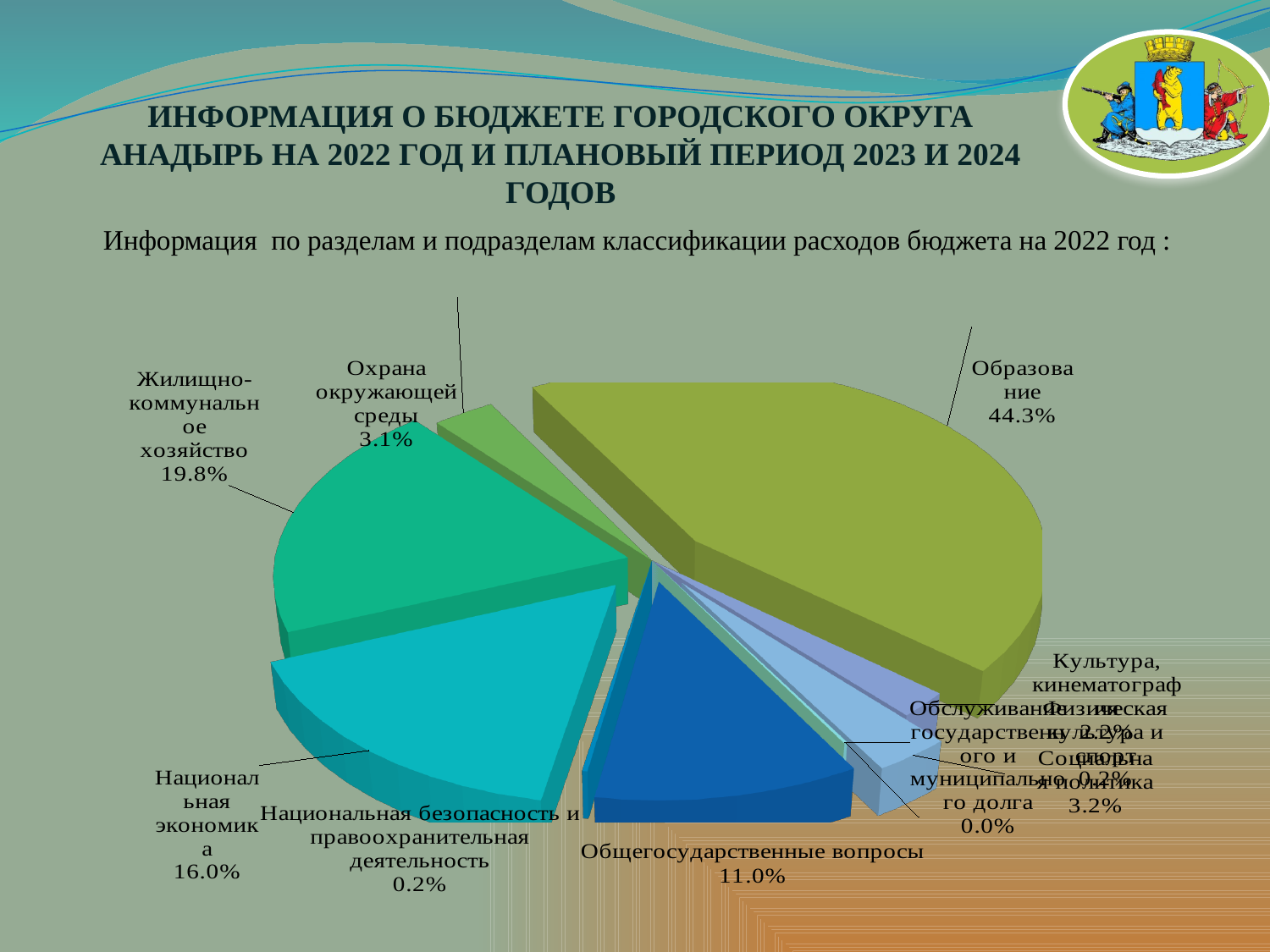
What is the difference in percentage points between Образование and Жилищно-коммунальное хозяйство? 24.5% What percentage is shown for Национальная безопасность и правоохранительная деятельность? 0.2% What percentage is shown for Жилищно-коммунальное хозяйство? 19.8% Which is larger: the share for Национальная экономика or for Общегосударственные вопросы? Национальная экономика What percentage is shown for Общегосударственные вопросы? 11.0% What share of the 2022 budget expenditures goes to Образование? 44.3% Which section has the largest share of the budget expenditures? Образование What percentage is shown for Национальная экономика? 16.0% Which section has the smallest share, at 0.0%? Обслуживание государственного и муниципального долга What type of chart is shown on the slide? Pie chart Which year's budget expenditures does the chart describe? 2022 What percentage is shown for Охрана окружающей среды? 3.1%